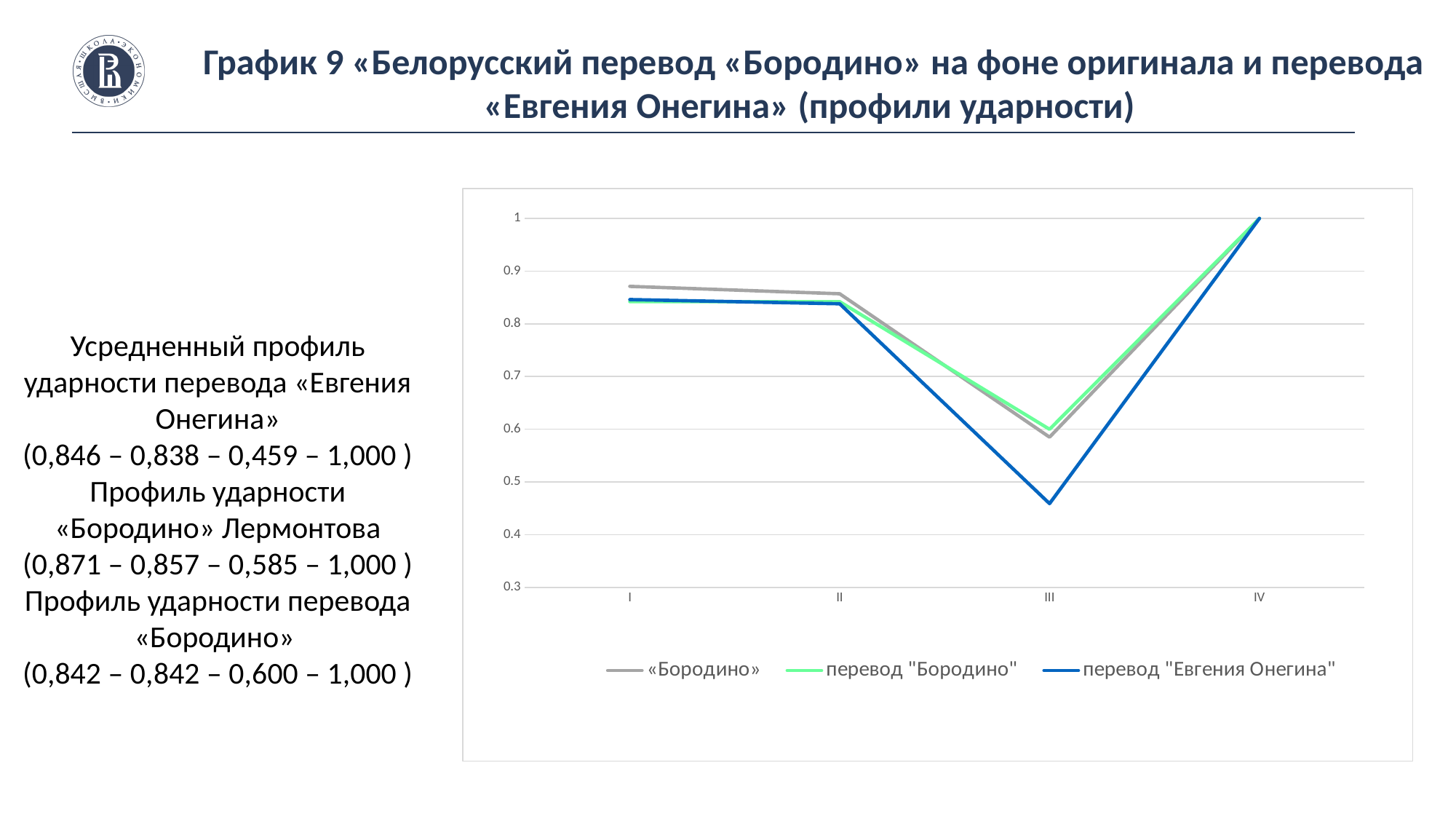
Do the values of the series fall or rise from position II to position III? fall Is the value for перевод "Евгения Онегина" at position III greater or less than 0.5? less According to the profile printed on the slide, what is the value of перевод "Евгения Онегина" at position III? 0,459 How many positions are shown along the x axis of the chart? 4 What kind of chart is shown on the slide? line chart Is the value for «Бородино» at position III greater or less than 0.5? greater At which position does the series перевод "Евгения Онегина" reach its lowest value? III What colour is the line for перевод "Евгения Онегина" in the chart? blue What value do all three series reach at position IV? 1 Do the values of the series fall or rise from position III to position IV? rise At position III, which series has the higher value: «Бородино» or перевод "Евгения Онегина"? «Бородино» How many series does the legend of the chart list? 3